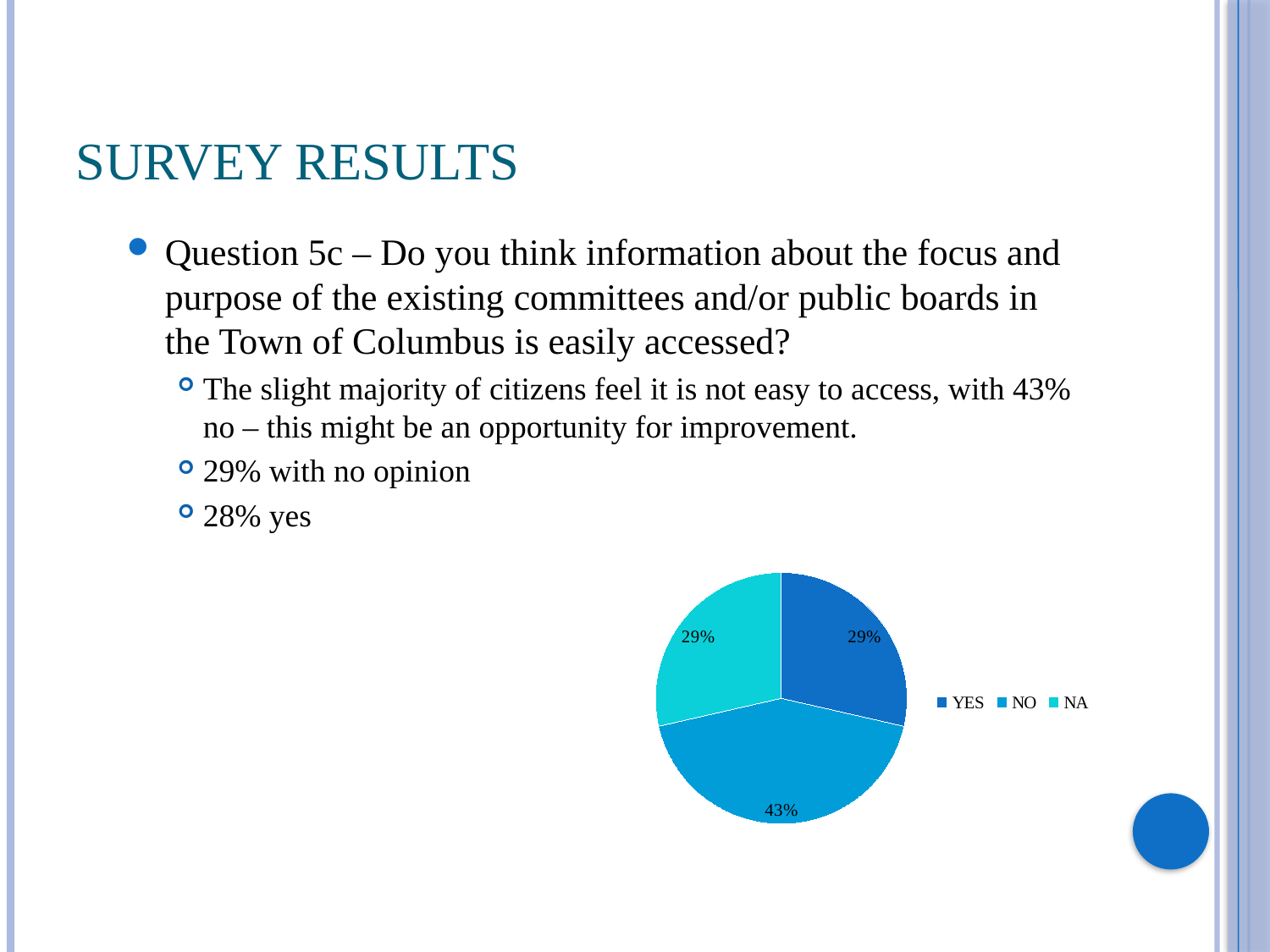
What percentage does the pie chart show for YES? 29% What kind of chart is shown on the slide? pie chart What is the combined share of the YES and NA slices in the pie chart? 58% Is the NO slice greater or less than 40%? greater How many slices does the pie chart have? 3 What percentage does the pie chart show for NA? 29% What percentage of the pie chart is labelled for the NO slice? 43% Which category has the largest slice in the pie chart? NO What is the difference in percentage points between the NO slice and the YES slice? 14% How many entries does the legend of the pie chart list? 3 What are the legend entries of the pie chart, in order? YES, NO, NA Which slice is larger in the pie chart, NO or NA? NO